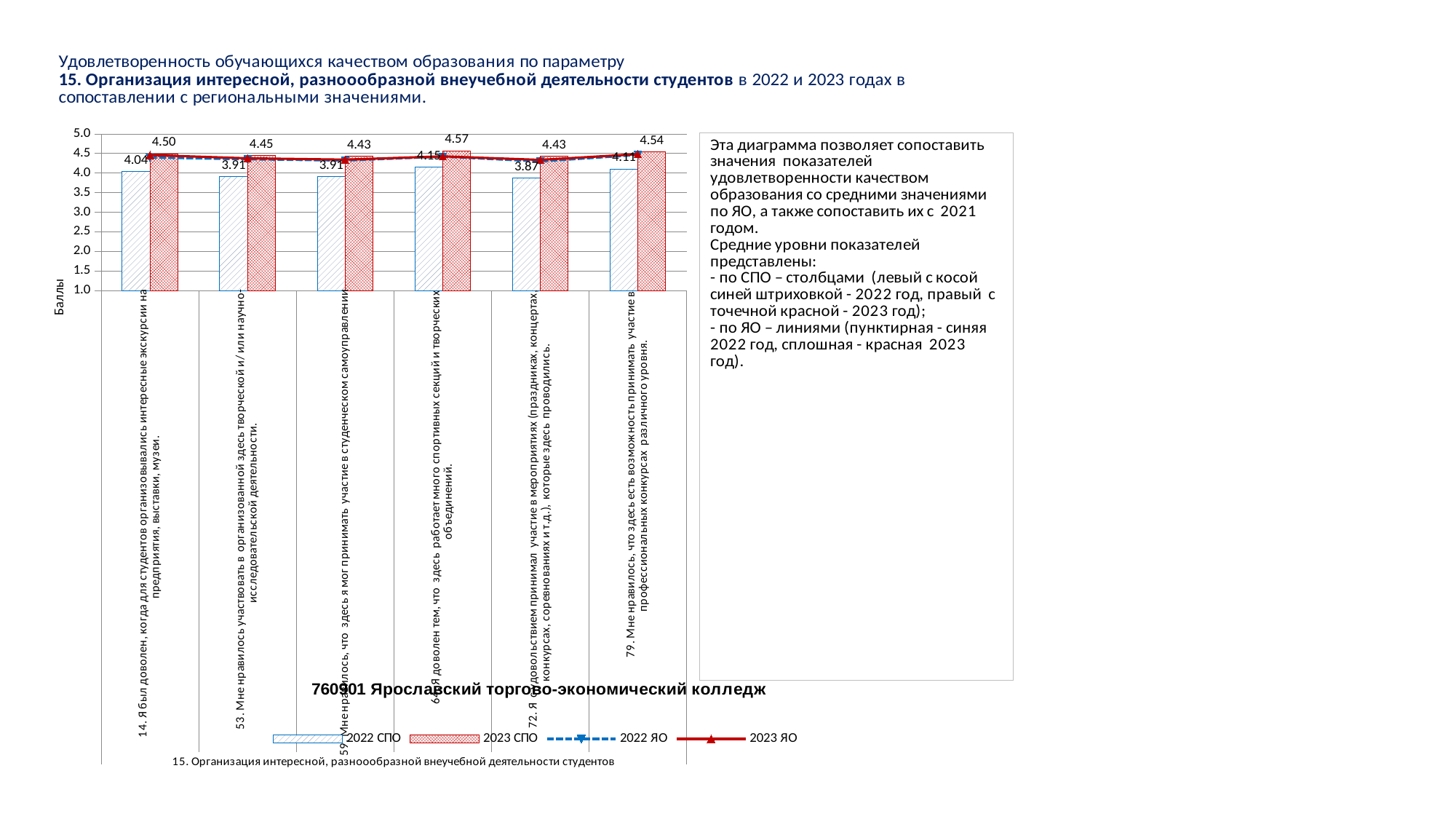
What is the 2023 СПО value for category 79 (Мне нравилось, что здесь есть возможность принимать участие в профессиональных конкурсах)? 4.54 How many categories are shown on the x axis of the chart? 6 What kind of chart is shown on the slide? A bar chart combined with line series What is the 2022 СПО value for category 72 (Я с удовольствием принимал участие в мероприятиях)? 3.87 How many series does the chart legend list? 4 Which category has the lowest 2022 СПО value? 72 (3.87) Is the 2022 ЯО line value for category 14 greater or less than 4.0? greater What is the difference between the 2023 СПО and 2022 СПО values for category 64? 0.42 Which category has the highest 2023 СПО value? 64 (4.57) What is the title of the vertical axis of the chart? Баллы Which is larger: the 2022 СПО value for category 14 or for category 53? Category 14 (4.04) What is the 2023 СПО value for category 14 (Я был доволен, когда для студентов организовывались интересные экскурсии)? 4.50